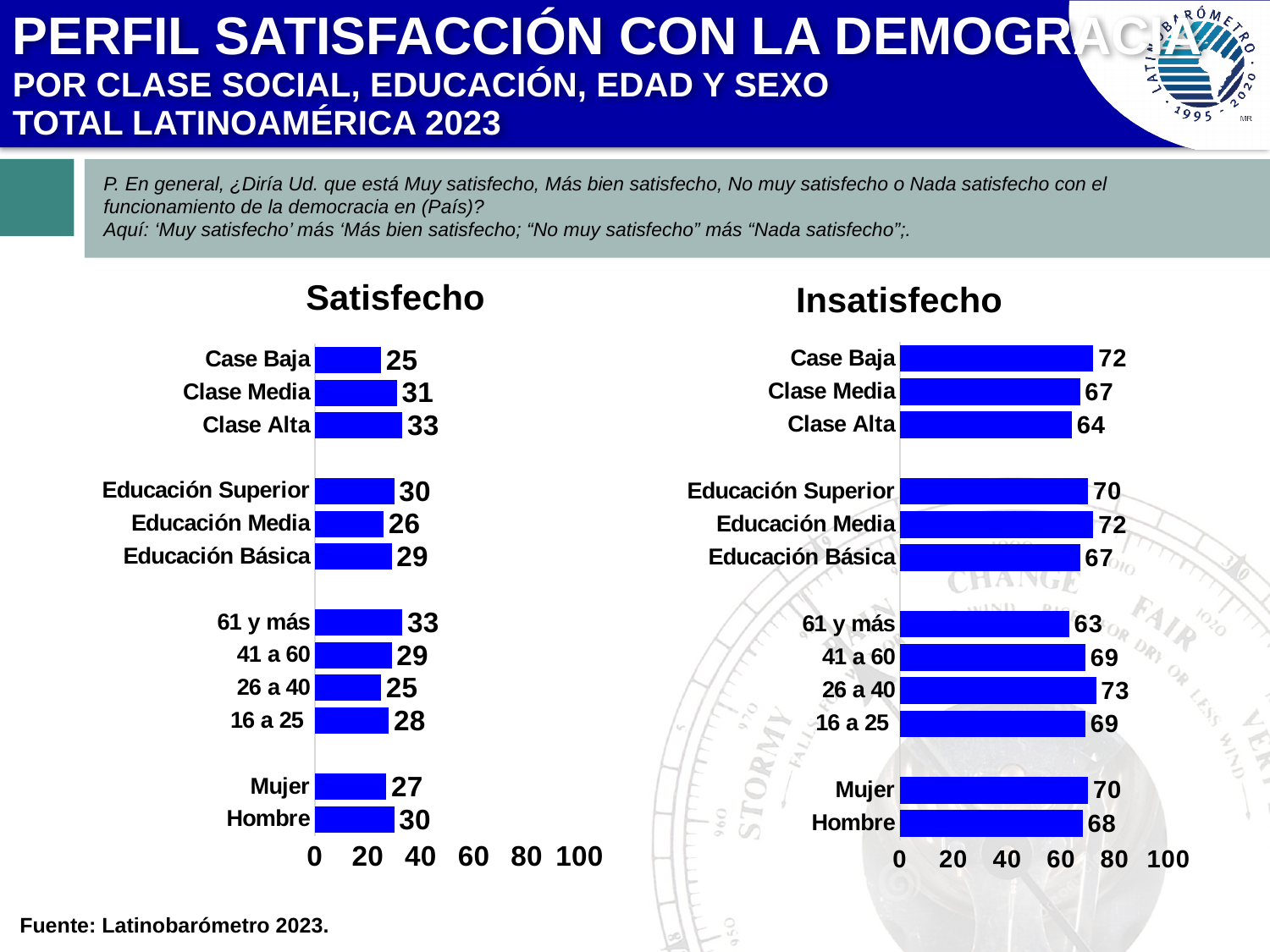
In the Satisfecho chart, which is larger, the value for Educación Superior or the value for Educación Media? Educación Superior In the Satisfecho chart, what is the value for Hombre? 30 In the Insatisfecho chart, what is the value for 16 a 25? 69 How many categories are shown in the Satisfecho chart? 12 In the Satisfecho chart, what is the value for Clase Media? 31 In the Satisfecho chart, what is the difference between the values for Clase Alta and Case Baja? 8 In the Insatisfecho chart, is the value for Clase Alta greater or less than 60? greater What kind of chart is the Insatisfecho chart? bar chart In the Insatisfecho chart, what is the value for Educación Superior? 70 In the Insatisfecho chart, what is the difference between the values for Mujer and Hombre? 2 In the Insatisfecho chart, which category has the highest value? 26 a 40 In the Insatisfecho chart, which category has the lowest value? 61 y más